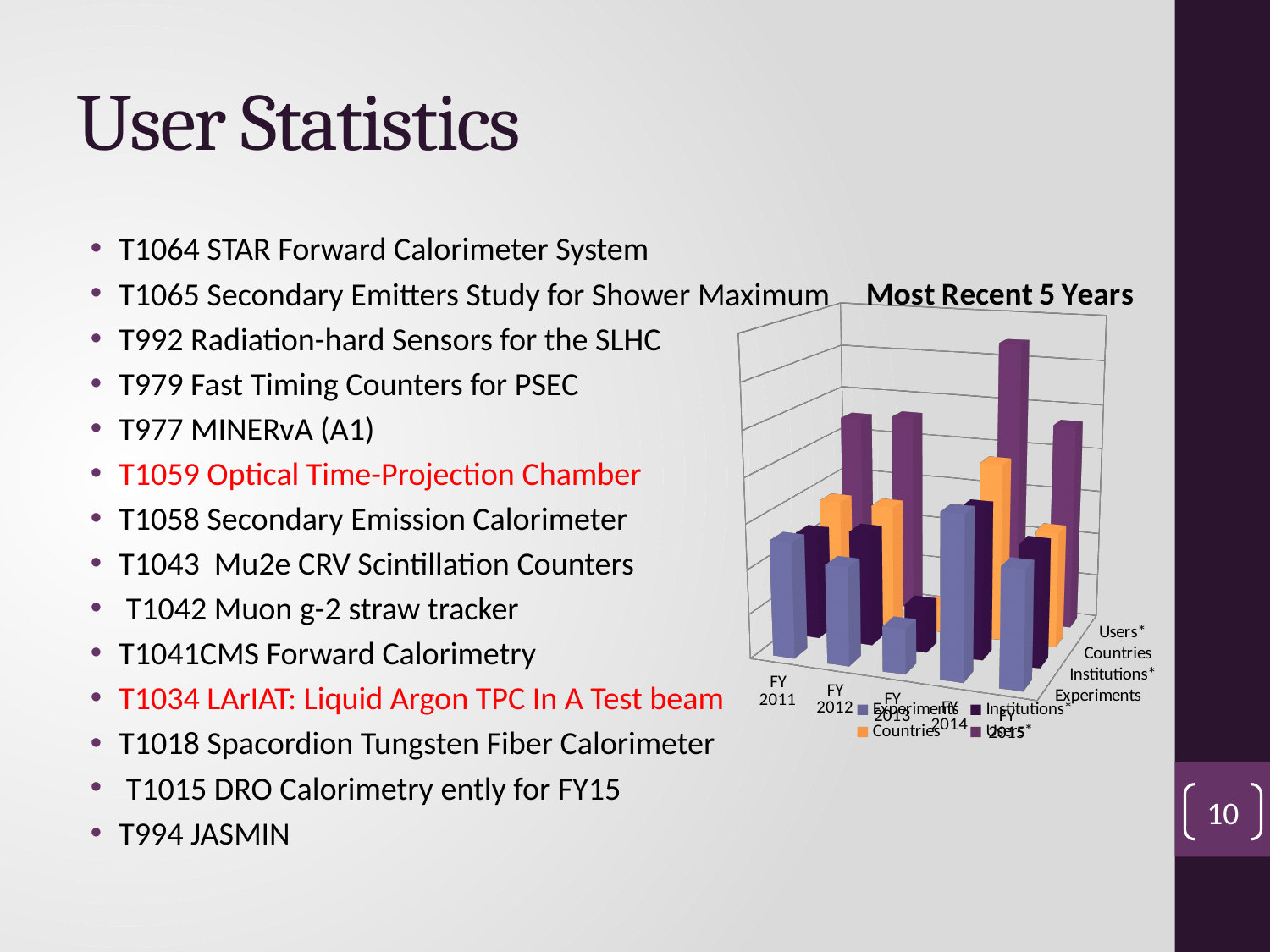
In which fiscal year is the Users* bar the tallest? FY 2014 Which fiscal year is the first category on the x axis of the chart? FY 2011 How many fiscal years are shown along the x axis of the chart? 5 Which series are listed in the chart's legend? Experiments, Institutions*, Countries, Users* Which is larger in FY 2014, the Users* bar or the Experiments bar? Users* What is the title of the chart on the slide? Most Recent 5 Years What kind of chart is shown on the slide? bar chart How many series does the chart's legend list? 4 In which fiscal year is the Countries bar the shortest? FY 2013